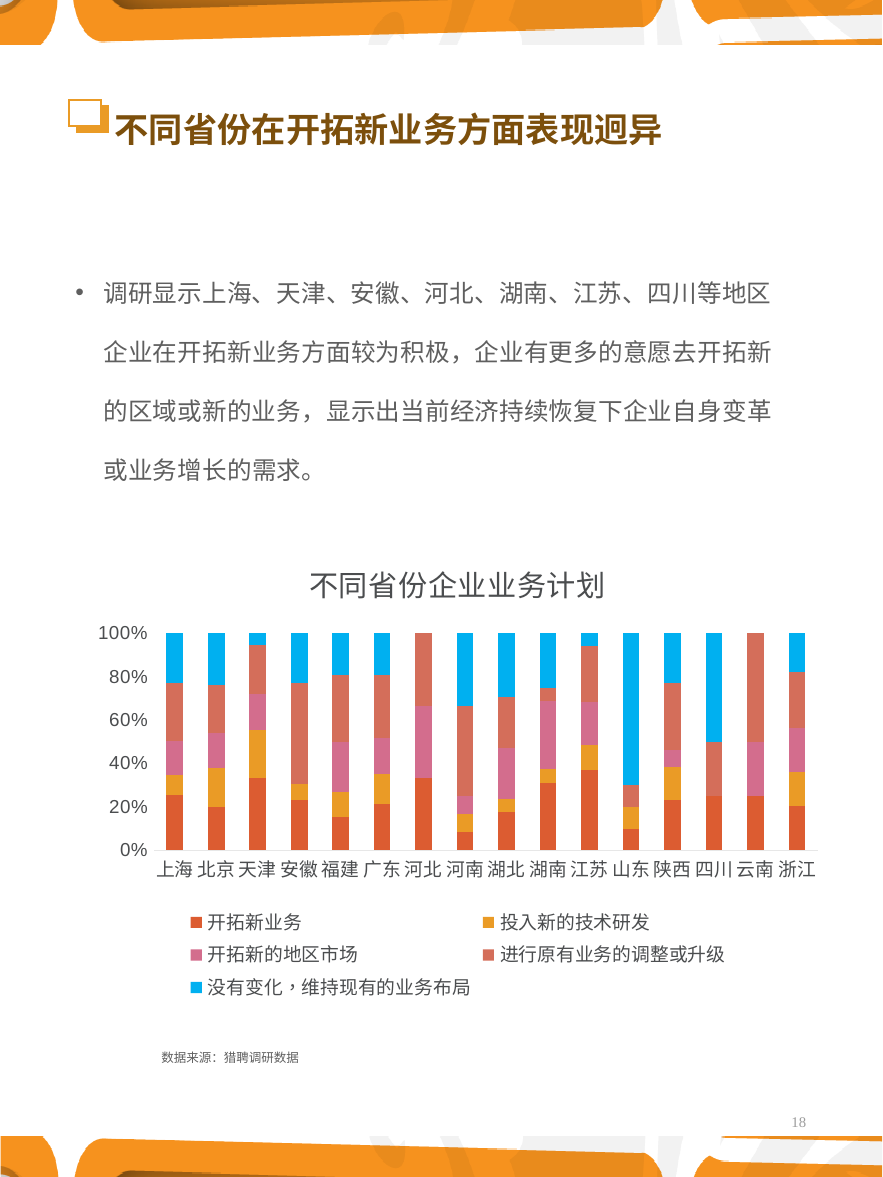
What is the title of the chart on the slide? 不同省份企业业务计划 Is the value of 开拓新业务 for 江苏 greater or less than 20%? greater How many series does the chart's legend list? 5 Is the value of 没有变化，维持现有的业务布局 for 山东 greater or less than 60%? greater What kind of chart is shown on the slide? Stacked bar chart Is the value of 开拓新业务 for 天津 greater or less than 20%? greater How many provinces are shown on the x axis of the chart? 16 Which province has the larger share of 开拓新业务, 江苏 or 河南? 江苏 Which province has the larger share of 没有变化，维持现有的业务布局, 山东 or 上海? 山东 What is the data source stated below the chart? 猎聘调研数据